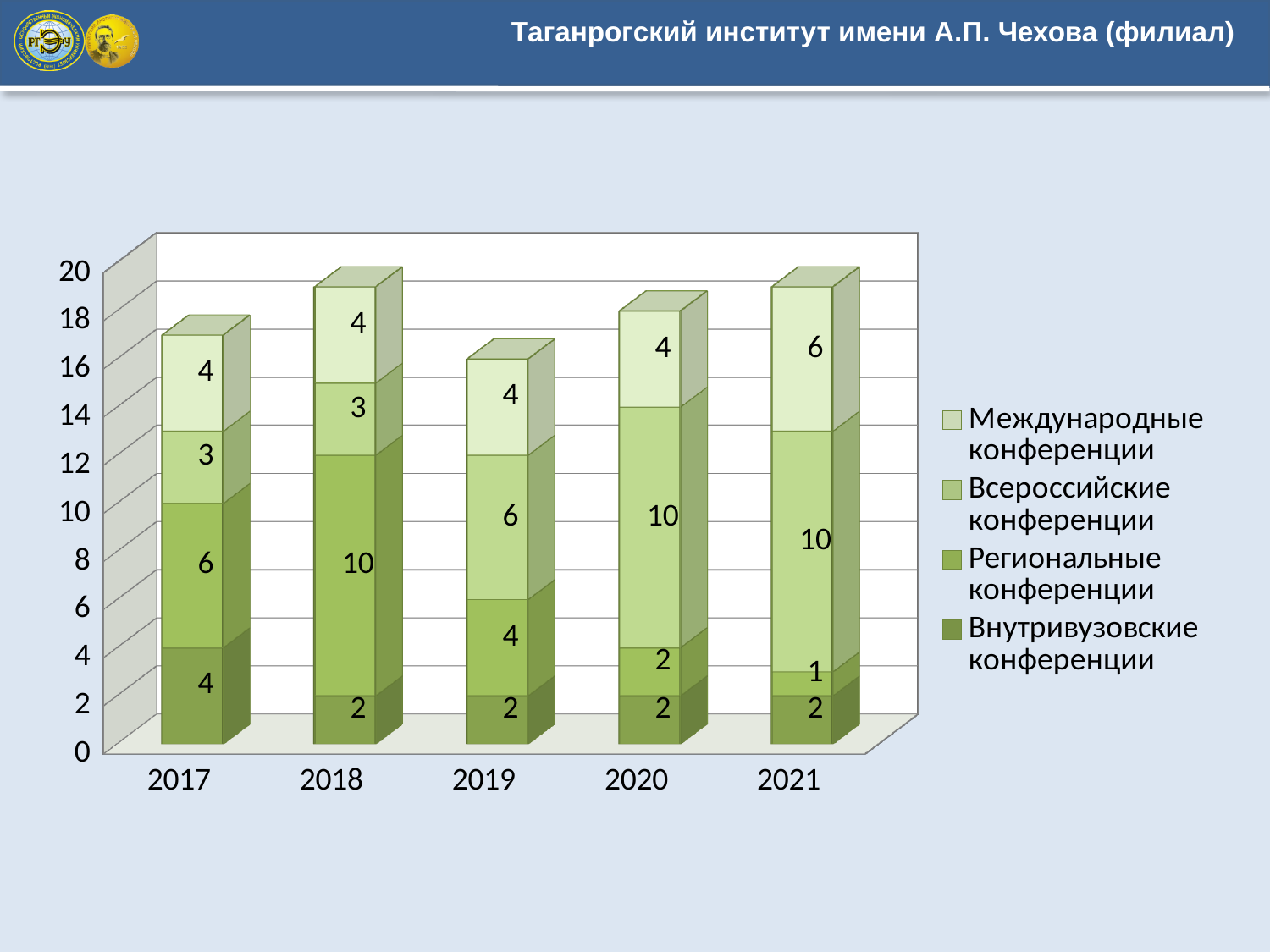
What is the total of the stacked bar for 2018? 19 What kind of chart is shown on the slide? stacked bar chart Which year has the lowest value for Региональные конференции? 2021 What is the difference between Всероссийские конференции in 2020 and in 2017? 7 What is the total of the stacked bar for 2019? 16 Which is larger: Региональные конференции in 2017 or Региональные конференции in 2019? 2017 What is the value for Международные конференции in 2021? 6 What is the value for Региональные конференции in 2018? 10 How many years are shown on the x axis? 5 How many series does the legend list? 4 What is the value for Всероссийские конференции in 2019? 6 What is the value for Внутривузовские конференции in 2017? 4